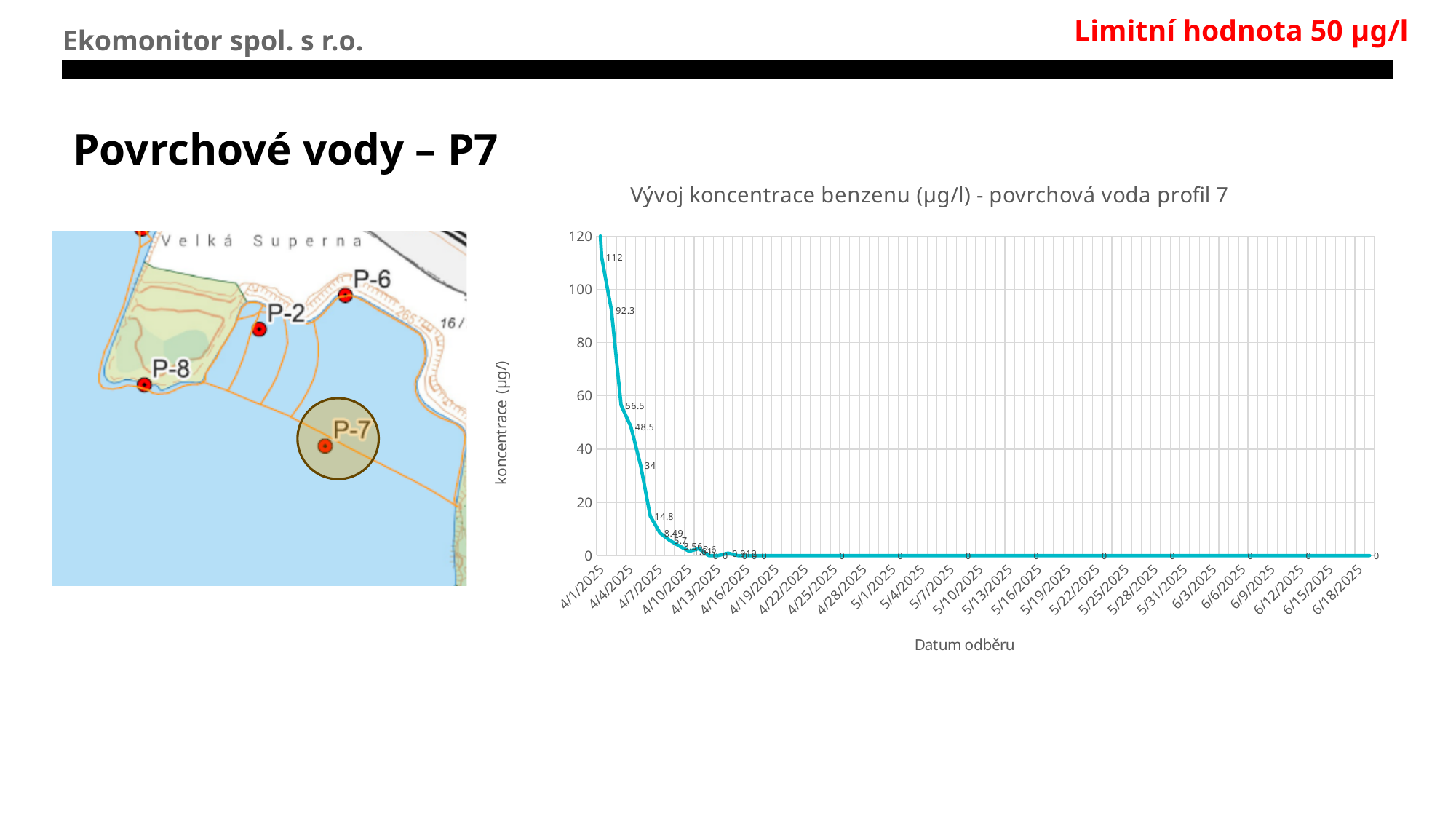
What is the label of the vertical axis of the chart? koncentrace (µg/l) What kind of chart is shown on the slide? line chart What is the difference between the two highest labelled values, 112 and 92.3? 19.7 Do the values rise or fall along the x axis from 4/1/2025 onward? fall Is the value for 4/1/2025 greater or less than 100? greater Which date has the larger value, 4/1/2025 or 6/18/2025? 4/1/2025 What is the title of the chart? Vývoj koncentrace benzenu (µg/l) - povrchová voda profil 7 Is the value for 5/1/2025 greater or less than 20? less What is the value plotted for 6/18/2025? 0 How many data-labelled values on the chart exceed the limit of 50 µg/l? 3 What is the value plotted for 5/16/2025? 0 What is the highest data-labelled value on the chart? 112